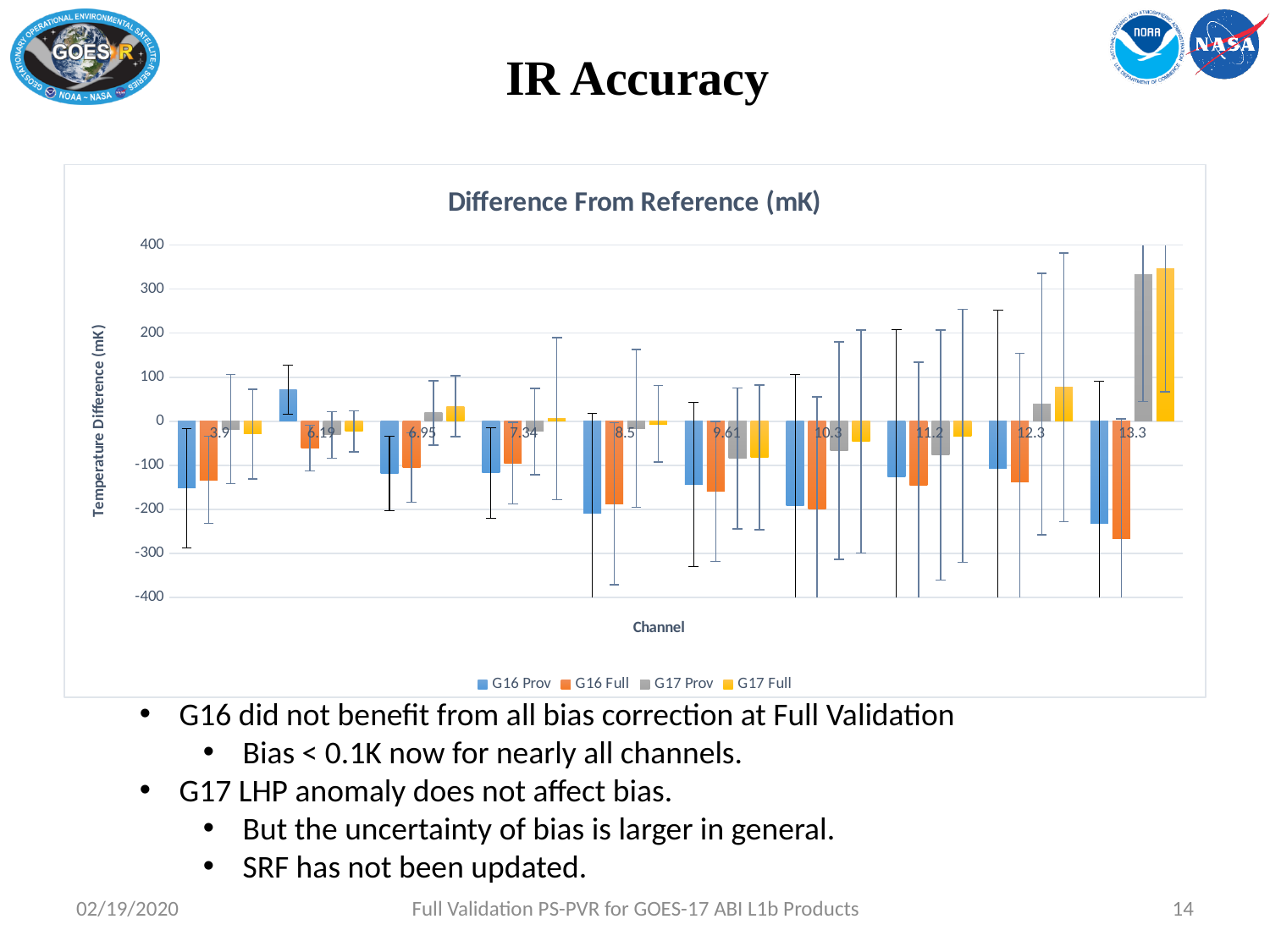
For which channel is the G16 Full value the lowest? 13.3 Is the G16 Prov value for channel 6.19 greater or less than 0? greater What type of chart is shown on the slide? bar chart Is the G16 Full value for channel 13.3 greater or less than -200? less What is the title of the chart? Difference From Reference (mK) Which is larger, the G16 Prov value for channel 6.19 or the G16 Prov value for channel 3.9? 6.19 What is the label of the y axis of the chart? Temperature Difference (mK) How many channels are shown along the x axis of the chart? 10 For which channel is the G17 Full value the highest? 13.3 How many series does the legend of the chart list? 4 Is the G17 Prov value for channel 13.3 greater or less than 300? greater